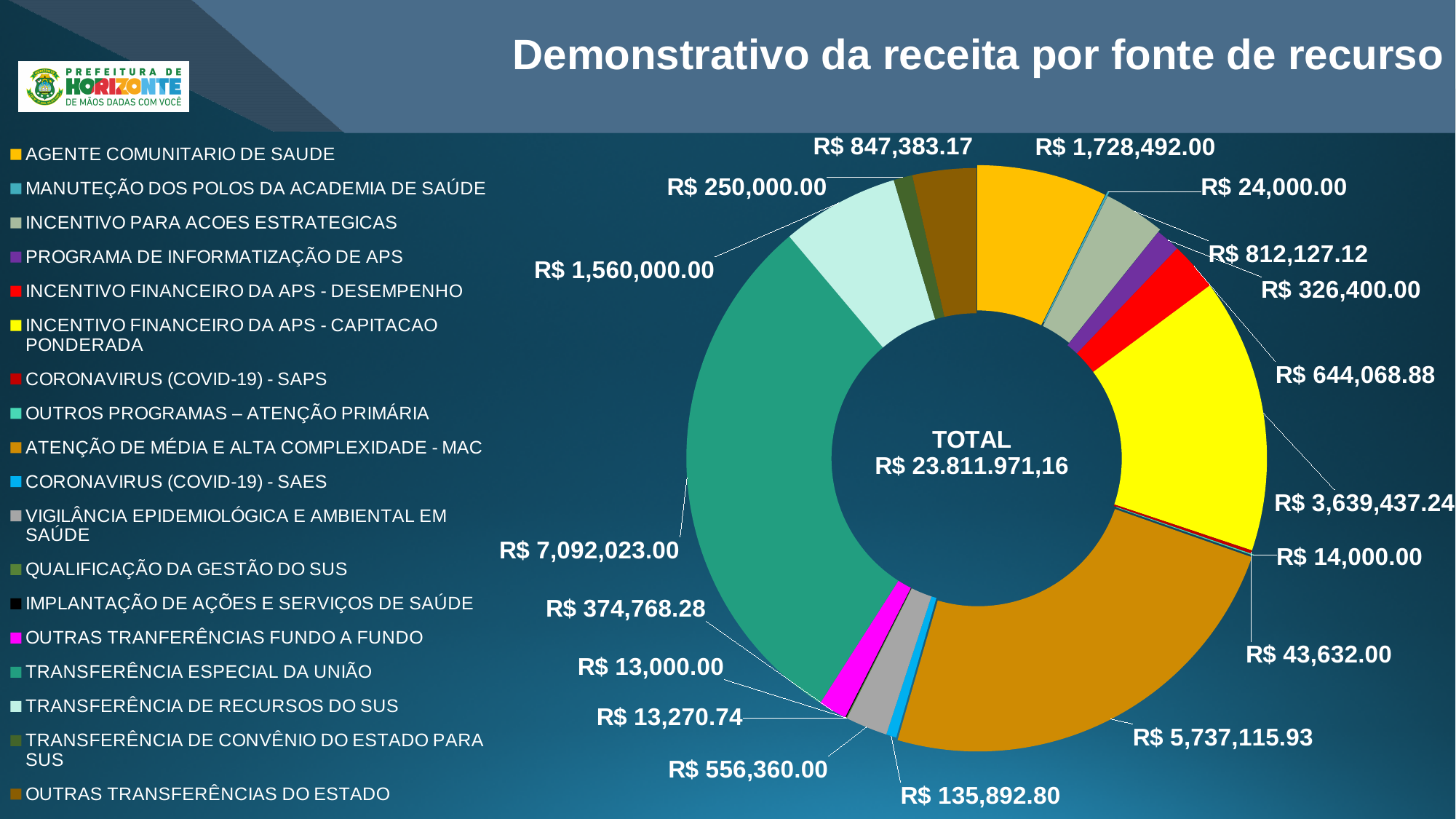
What kind of chart is shown on the slide? Pie chart (doughnut) What is the value for ATENÇÃO DE MÉDIA E ALTA COMPLEXIDADE - MAC? R$ 5,737,115.93 What is the value for INCENTIVO FINANCEIRO DA APS - CAPITACAO PONDERADA? R$ 3,639,437.24 How many categories does the legend list? 18 Which category has the largest slice of the chart? TRANSFERÊNCIA ESPECIAL DA UNIÃO Which is larger: INCENTIVO FINANCEIRO DA APS - CAPITACAO PONDERADA or AGENTE COMUNITARIO DE SAUDE? INCENTIVO FINANCEIRO DA APS - CAPITACAO PONDERADA What is the value for AGENTE COMUNITARIO DE SAUDE? R$ 1,728,492.00 What total is printed in the centre of the chart? R$ 23.811.971,16 What is the title of the slide's chart? Demonstrativo da receita por fonte de recurso What is the value for TRANSFERÊNCIA ESPECIAL DA UNIÃO? R$ 7,092,023.00 What is the difference between the values for TRANSFERÊNCIA ESPECIAL DA UNIÃO and ATENÇÃO DE MÉDIA E ALTA COMPLEXIDADE - MAC? R$ 1,354,907.07 What is the value for TRANSFERÊNCIA DE RECURSOS DO SUS? R$ 1,560,000.00